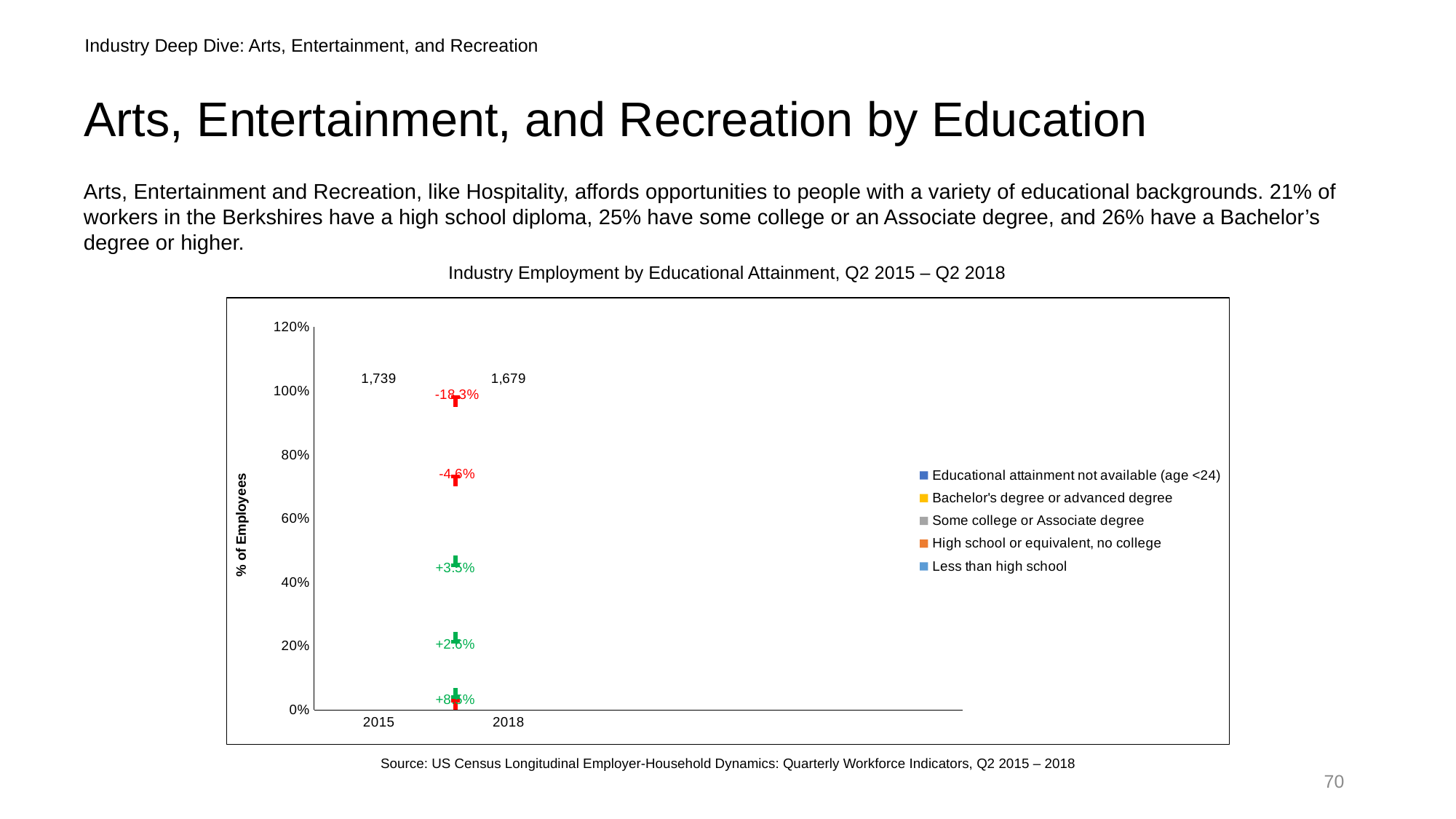
What is the title of the chart? Industry Employment by Educational Attainment, Q2 2015 – Q2 2018 What is the difference between the labelled totals for 2015 (1,739) and 2018 (1,679)? 60 Which year has the larger labelled total employment, 2015 or 2018? 2015 How many year categories are shown on the x axis? 2 What total employment figure is labelled above the 2015 category? 1,739 What percentage change is printed in red nearest the top of the chart, around the 100% line? -18.3% How many series does the legend list? 5 What total employment figure is labelled above the 2018 category? 1,679 What is the label on the y axis? % of Employees What is the highest value shown on the y axis? 120%